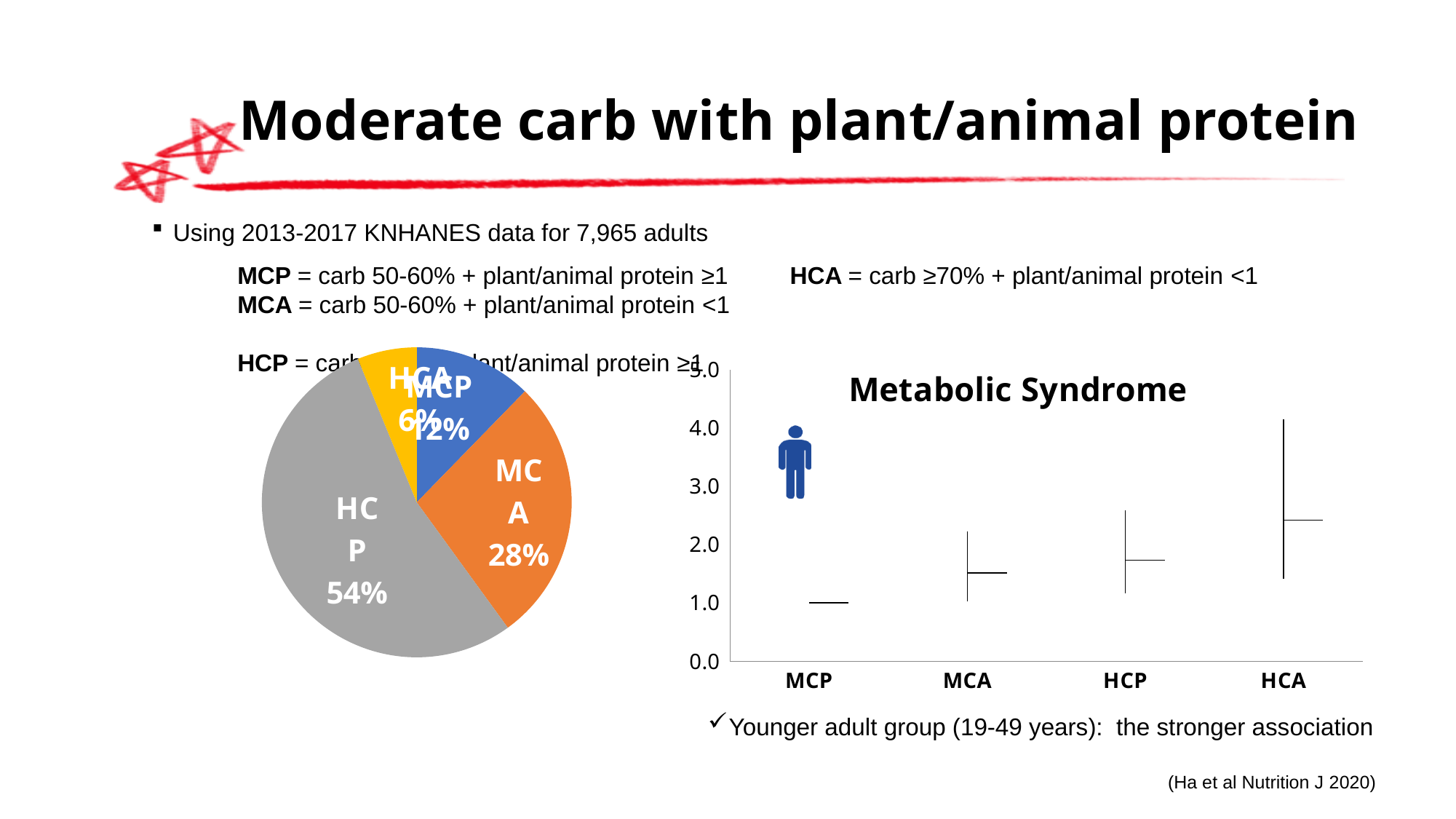
How many slices does the pie chart on the left have? 4 In the pie chart on the left, which category has the smallest slice? HCA In the pie chart on the left, which is larger, the MCA slice or the MCP slice? MCA In the Metabolic Syndrome chart, is the value for MCA greater or less than 2.0? less In the pie chart on the left, what share does MCA have? 28% In the pie chart on the left, which category has the largest slice? HCP In the pie chart on the left, what is the difference between the HCP share and the MCA share? 26% In the Metabolic Syndrome chart, is the value for HCA greater or less than 2.0? greater What kind of chart is the chart on the left? Pie chart In the pie chart on the left, what share does MCP have? 12% In the pie chart on the left, what share does HCP have? 54% In the Metabolic Syndrome chart, which category has the highest plotted value? HCA